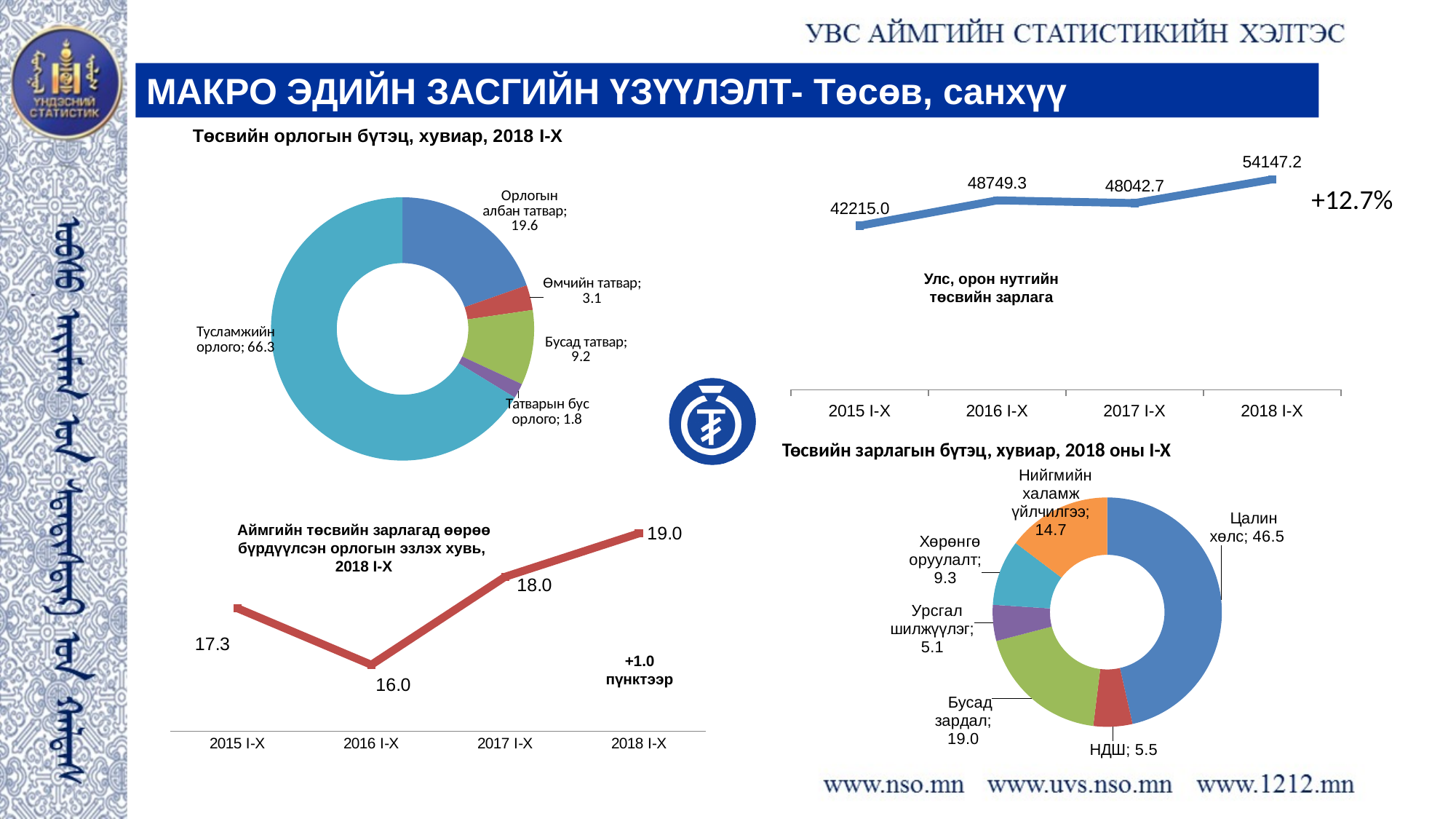
In the chart 'Төсвийн зарлагын бүтэц, хувиар, 2018 оны I-X', what is the value for 'Цалин хөлс'? 46.5 In the chart 'Төсвийн зарлагын бүтэц, хувиар, 2018 оны I-X', which is larger: 'Хөрөнгө оруулалт' or 'Нийгмийн халамж үйлчилгээ'? Нийгмийн халамж үйлчилгээ In the chart 'Улс, орон нутгийн төсвийн зарлага', what is the value for 2016 I-X? 48749.3 What type of chart is 'Улс, орон нутгийн төсвийн зарлага'? line chart In the chart 'Аймгийн төсвийн зарлагад өөрөө бүрдүүлсэн орлогын эзлэх хувь, 2018 I-X', what is the value for 2016 I-X? 16.0 In the chart 'Төсвийн орлогын бүтэц, хувиар, 2018 I-X', what is the difference between 'Орлогын албан татвар' and 'Бусад татвар'? 10.4 In the chart 'Улс, орон нутгийн төсвийн зарлага', which year has the highest value? 2018 I-X In the chart 'Төсвийн орлогын бүтэц, хувиар, 2018 I-X', which category has the smallest share? Татварын бус орлого In the chart 'Аймгийн төсвийн зарлагад өөрөө бүрдүүлсэн орлогын эзлэх хувь, 2018 I-X', which year has the lowest value? 2016 I-X In the chart 'Төсвийн орлогын бүтэц, хувиар, 2018 I-X', what is the value for 'Тусламжийн орлого'? 66.3 In the chart 'Төсвийн орлогын бүтэц, хувиар, 2018 I-X', how many categories are shown? 5 In the chart 'Улс, орон нутгийн төсвийн зарлага', what is the difference between 2018 I-X and 2017 I-X? 6104.5